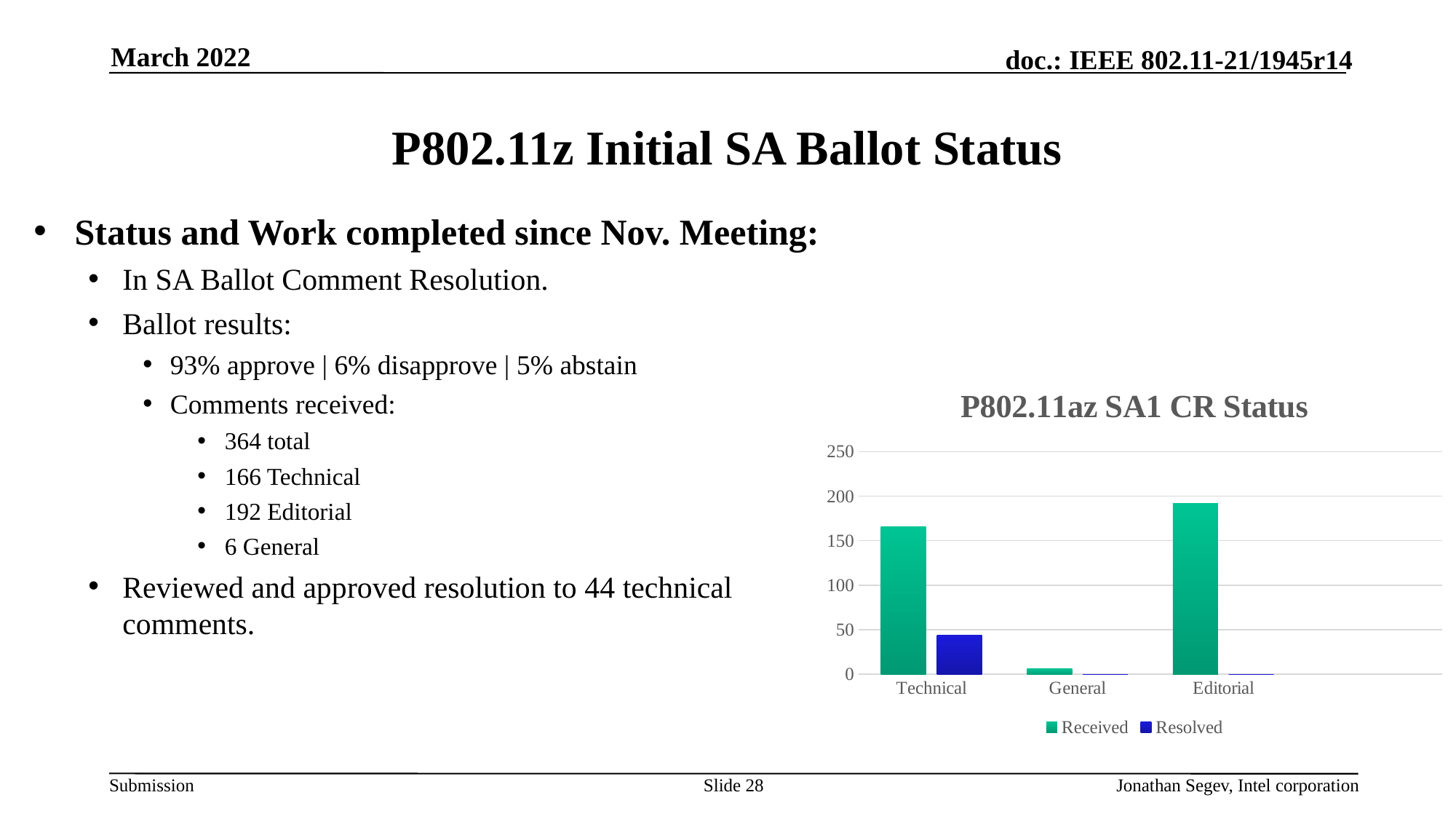
Which category has the highest Resolved value? Technical What is the title of the chart? P802.11az SA1 CR Status Which category has the lowest Received value? General Is the Received value for Editorial greater or less than 150? greater Which is larger, the Received value for Technical or the Received value for Editorial? Editorial How many series does the chart legend list? 2 Is the Received value for General greater or less than 50? less What kind of chart is shown on the slide? bar chart How many categories are shown on the x axis of the chart? 3 Which colour represents the Resolved series in the chart? blue Which category has the highest Received value? Editorial Is the Resolved value for Technical greater or less than 50? less